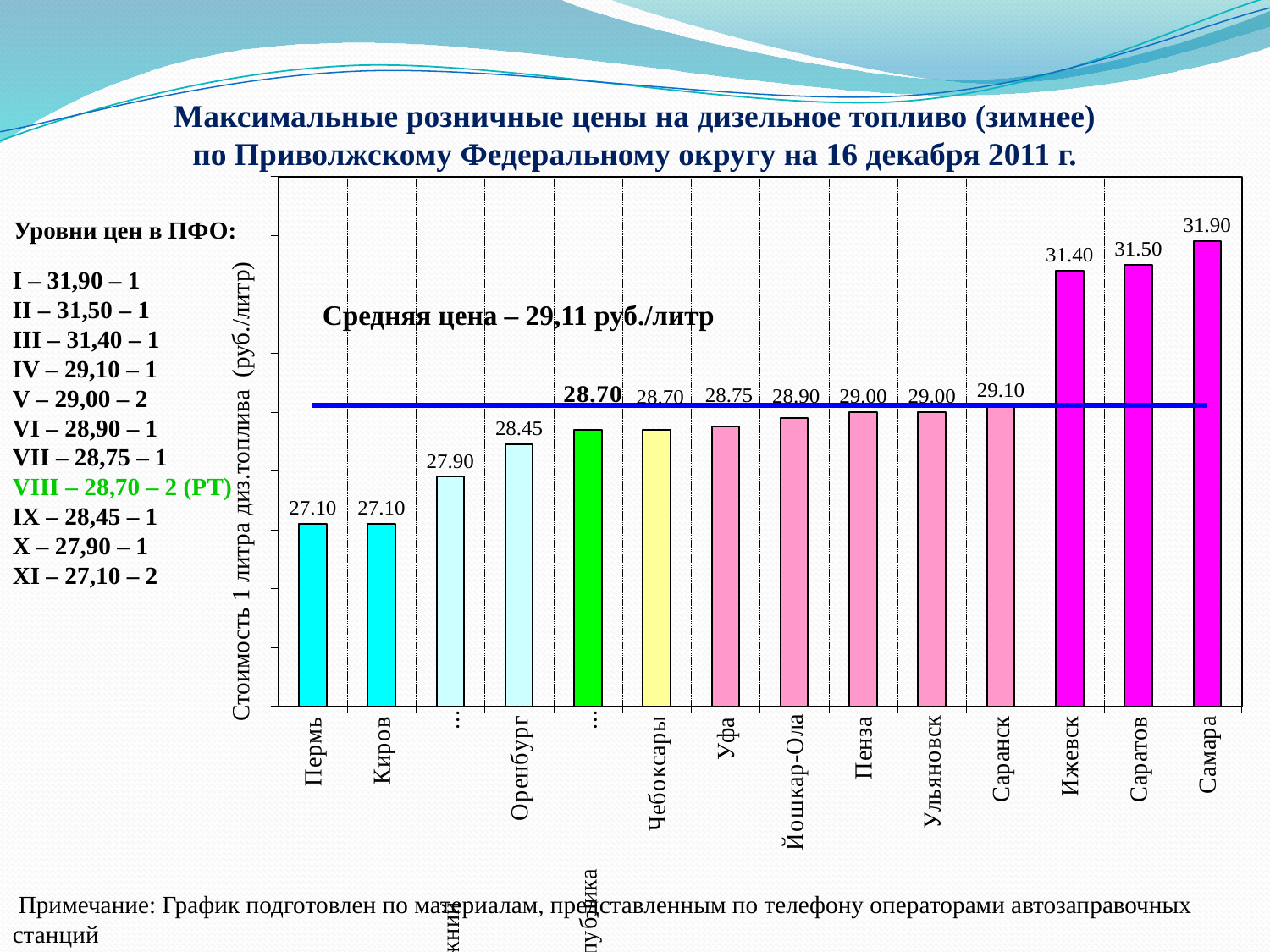
What kind of chart is this? bar chart What average price is stated on the chart? 29,11 руб./литр What is the value for Самара? 31.90 Which city has the highest value? Самара What is the lowest value shown on the chart? 27.10 What is the value for Саранск? 29.10 Which is larger, the value for Ижевск or the value for Саратов? Саратов What is the difference between the values for Саратов and Ижевск? 0.10 What is the value for Оренбург? 28.45 What is the difference between the values for Самара and Пермь? 4.80 What is the value for Уфа? 28.75 How many bars are shown on the chart? 14